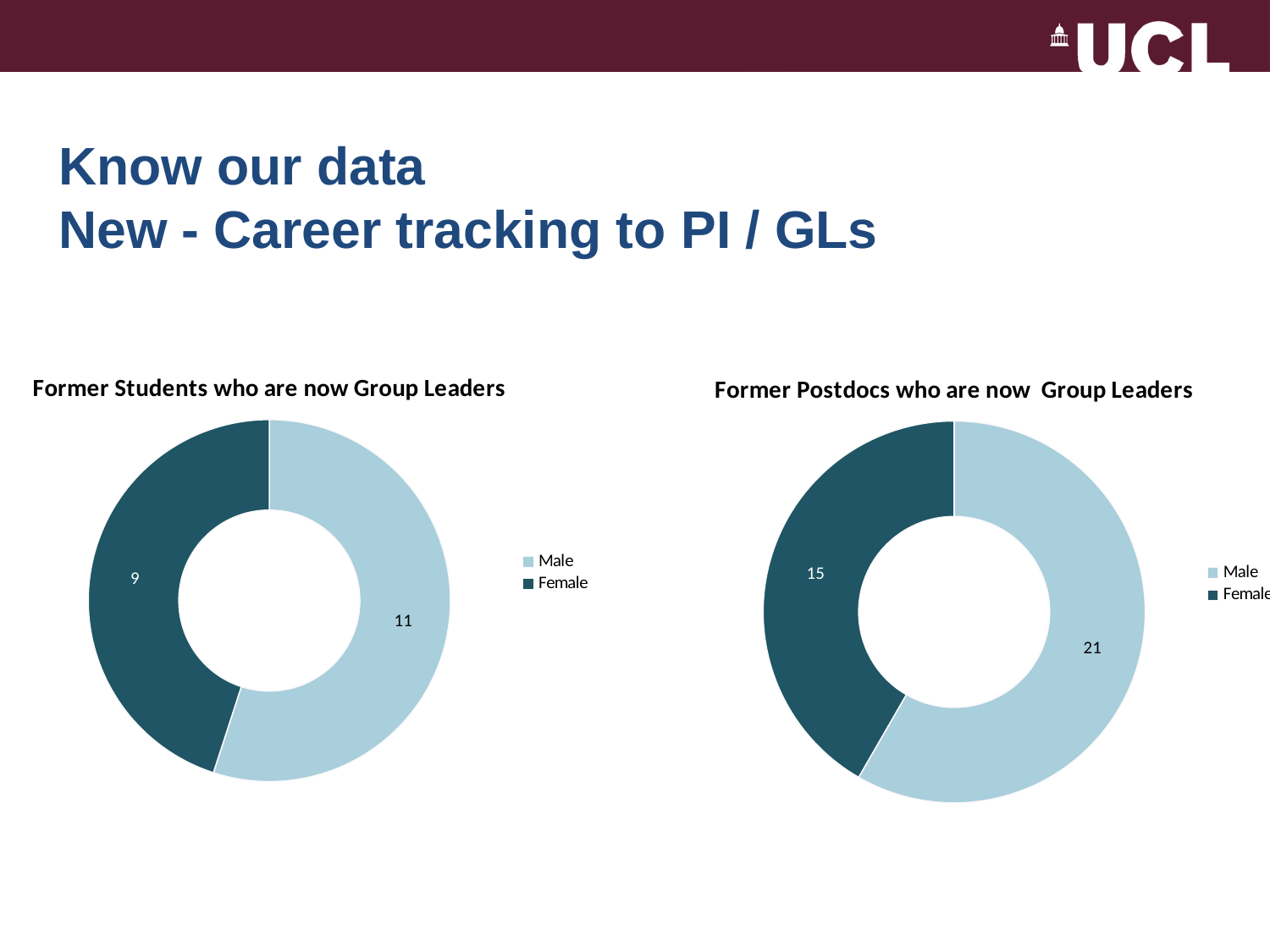
In the 'Former Students who are now Group Leaders' chart, what is the value for Male? 11 In the 'Former Postdocs who are now Group Leaders' chart, what is the difference between the Male and Female values? 6 In the 'Former Postdocs who are now Group Leaders' chart, what is the value for Female? 15 Is the Male value larger in the 'Former Students' chart or the 'Former Postdocs' chart? Former Postdocs What type of chart is the 'Former Students who are now Group Leaders' chart? Doughnut chart In the 'Former Students who are now Group Leaders' chart, what is the value for Female? 9 In the 'Former Students who are now Group Leaders' chart, which category has the smallest value? Female In the 'Former Students who are now Group Leaders' chart, what is the difference between the Male and Female values? 2 How many categories does the 'Former Postdocs who are now Group Leaders' chart show? 2 In the 'Former Postdocs who are now Group Leaders' chart, which category has the largest value? Male In the 'Former Postdocs who are now Group Leaders' chart, what is the value for Male? 21